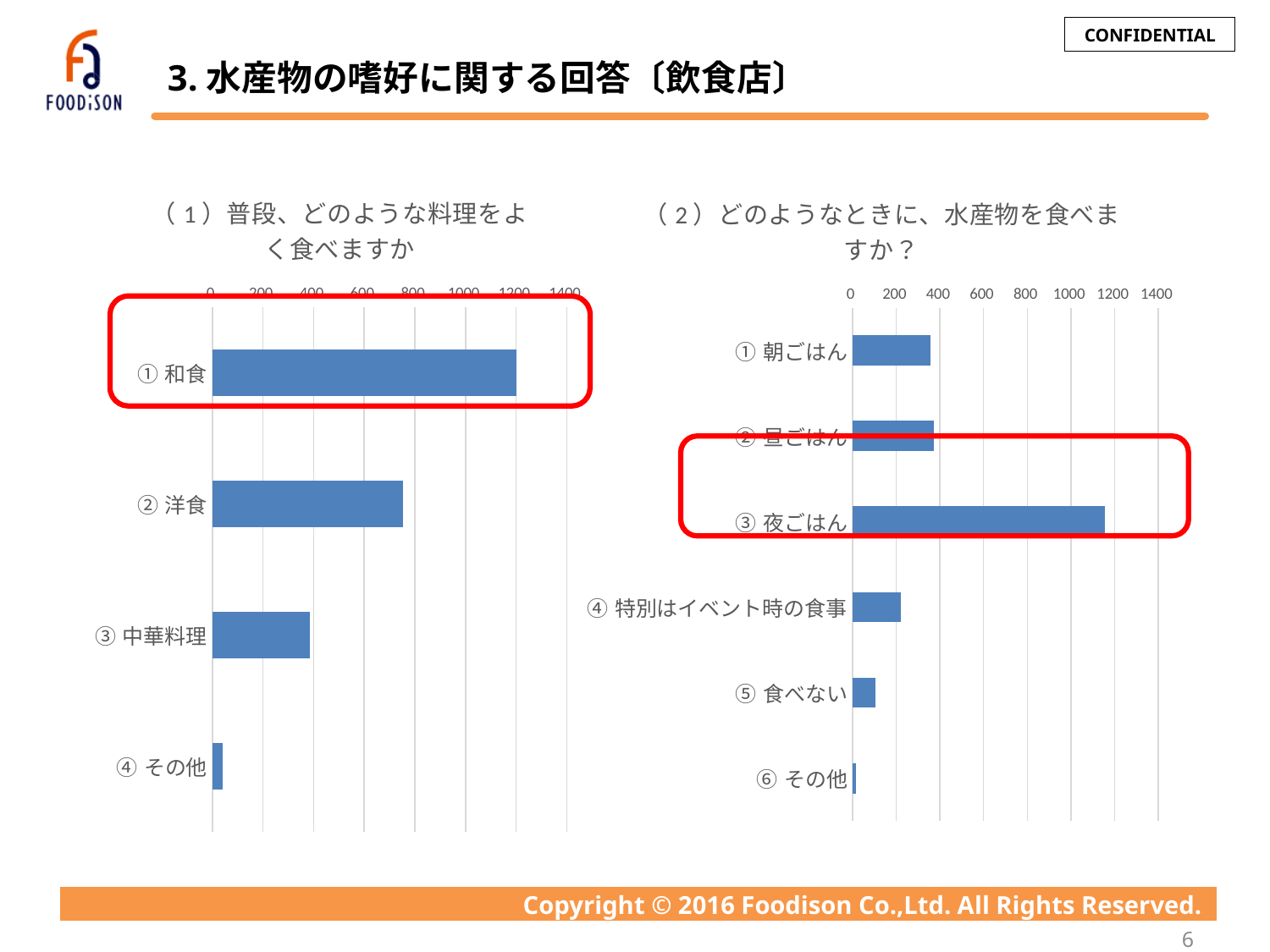
In the left chart (1) 普段、どのような料理をよく食べますか, is the value for ③ 中華料理 greater or less than 600? less In the left chart (1) 普段、どのような料理をよく食べますか, which category has the highest value? ① 和食 In the left chart (1) 普段、どのような料理をよく食べますか, is the value for ② 洋食 greater or less than 600? greater In the right chart (2) どのようなときに、水産物を食べますか？, is the value for ⑤ 食べない greater or less than 200? less What kind of chart is the right chart (2) どのようなときに、水産物を食べますか？? bar chart How many categories are shown in the right chart (2) どのようなときに、水産物を食べますか？? 6 In the left chart (1) 普段、どのような料理をよく食べますか, which category has the lowest value? ④ その他 In the right chart (2) どのようなときに、水産物を食べますか？, which category has the highest value? ③ 夜ごはん How many categories are shown in the left chart (1) 普段、どのような料理をよく食べますか? 4 In the right chart (2) どのようなときに、水産物を食べますか？, which category has the lowest value? ⑥ その他 In the left chart (1) 普段、どのような料理をよく食べますか, which is larger, ② 洋食 or ③ 中華料理? ② 洋食